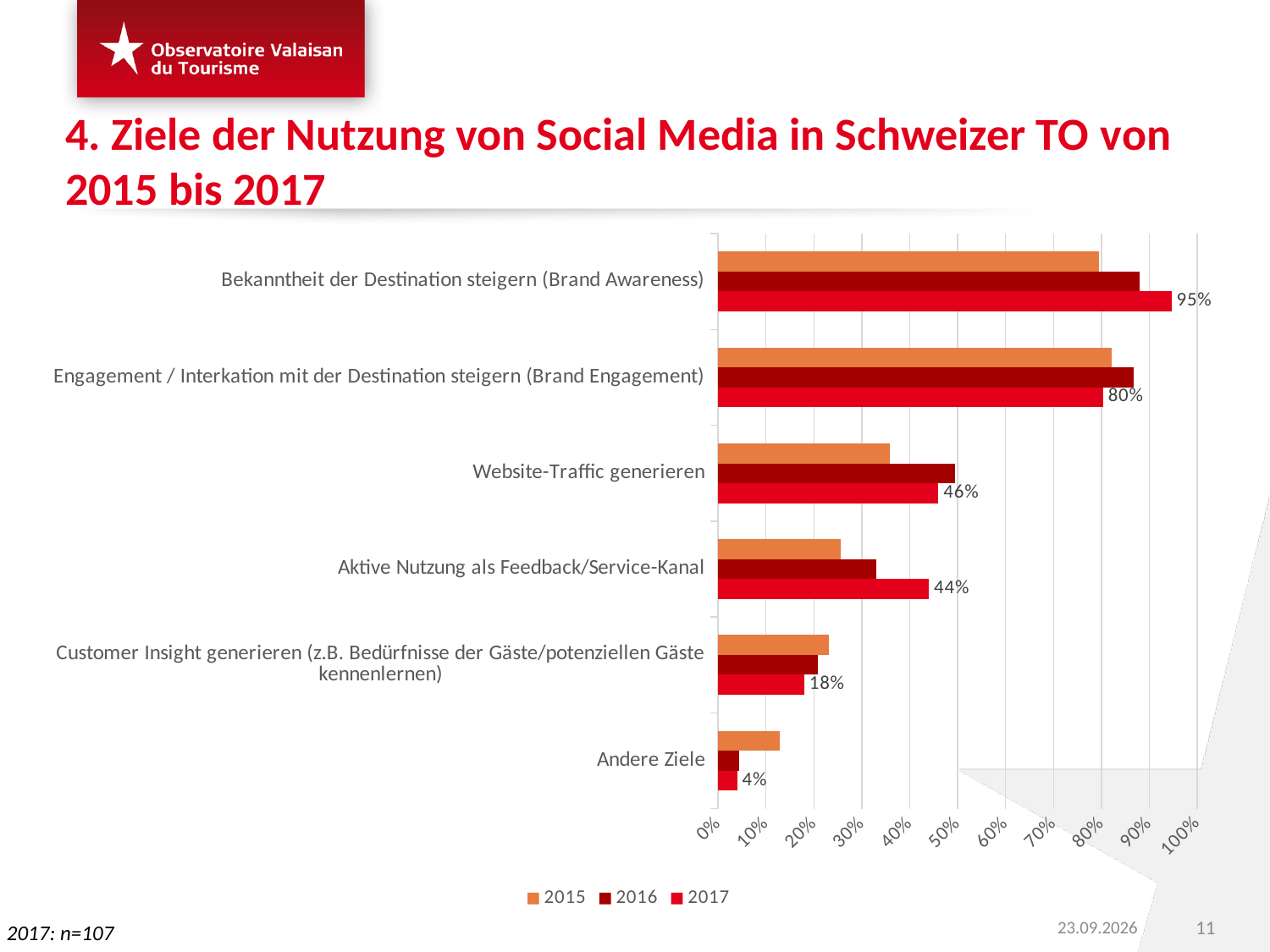
In 2017, which is larger: the value for "Engagement / Interkation mit der Destination steigern (Brand Engagement)" or for "Customer Insight generieren"? Engagement / Interkation mit der Destination steigern (Brand Engagement) How many categories are shown on the chart? 6 Is the 2015 value for "Andere Ziele" greater or less than 20%? less What is the 2017 value for "Bekanntheit der Destination steigern (Brand Awareness)"? 95% What is the 2017 value for "Andere Ziele"? 4% Which category has the highest 2017 value? Bekanntheit der Destination steigern (Brand Awareness) What kind of chart is shown on the slide? bar chart Is the 2015 value for "Bekanntheit der Destination steigern (Brand Awareness)" greater or less than 70%? greater What is the difference between the 2017 values for "Bekanntheit der Destination steigern (Brand Awareness)" and "Engagement / Interkation mit der Destination steigern (Brand Engagement)"? 15 percentage points What is the 2017 value for "Website-Traffic generieren"? 46% How many series does the legend list? 3 Which category has the lowest 2017 value? Andere Ziele